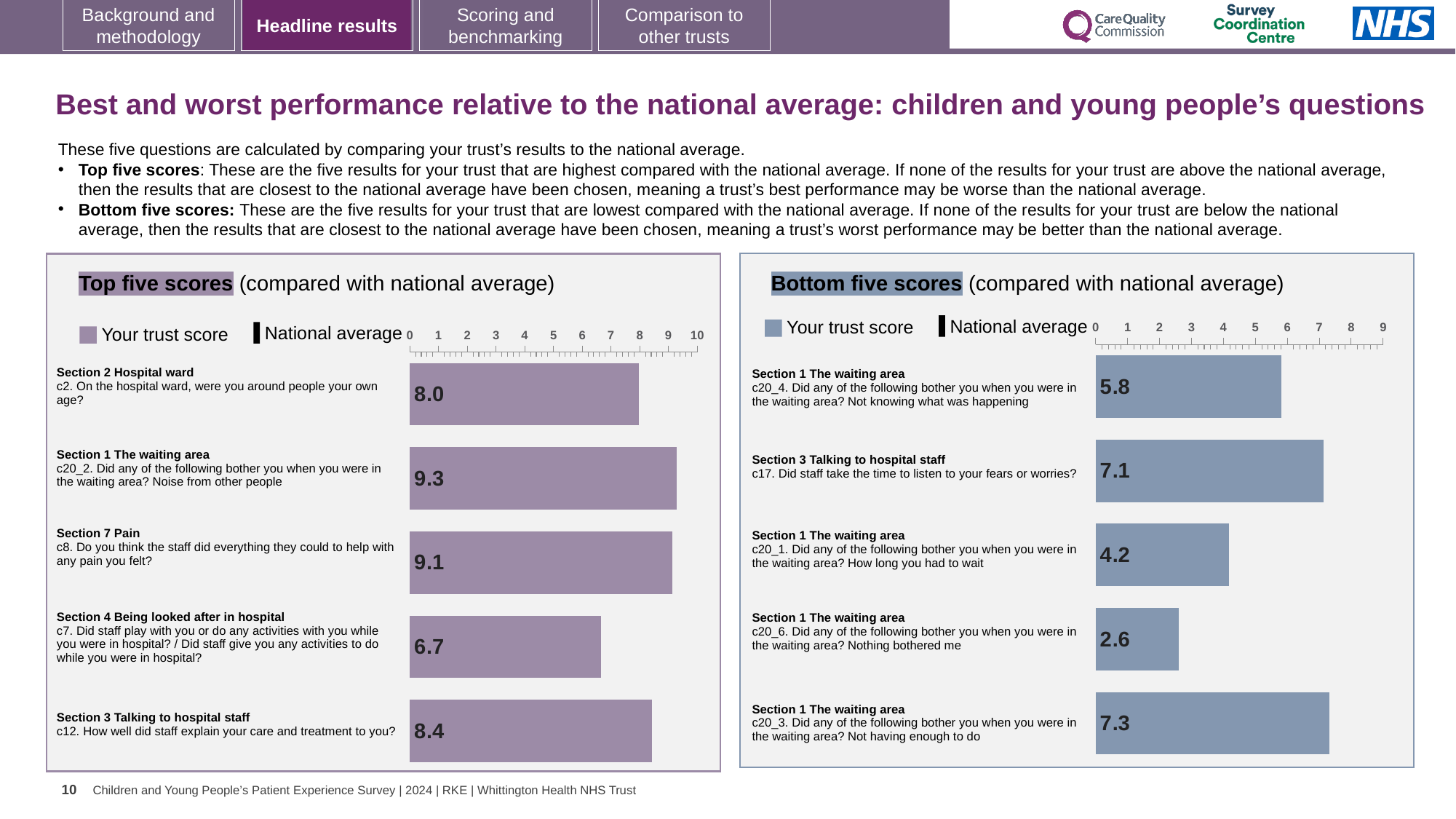
In the Bottom five scores chart, what is the trust score for c17 (Did staff take the time to listen to your fears or worries?)? 7.1 How many entries does the legend of the Top five scores chart list? 2 What kind of chart is the Bottom five scores chart? bar chart In the Top five scores chart, what is the difference between the trust scores for c20_2 and c7? 2.6 How many bars are plotted in the Top five scores chart? 5 In the Bottom five scores chart, which question has the lowest trust score? c20_6 (Nothing bothered me) In the Bottom five scores chart, is the trust score for c20_1 (How long you had to wait) greater or less than 5? less In the Bottom five scores chart, which has the larger trust score: c20_4 (Not knowing what was happening) or c20_3 (Not having enough to do)? c20_3 (Not having enough to do) In the Bottom five scores chart, what is the difference between the trust scores for c17 and c20_6? 4.5 In the Top five scores chart, what is the trust score for c12 (How well did staff explain your care and treatment to you?)? 8.4 In the Top five scores chart, which question has the highest trust score? c20_2 (Noise from other people) In the Top five scores chart, what is the trust score for c2 (On the hospital ward, were you around people your own age?)? 8.0